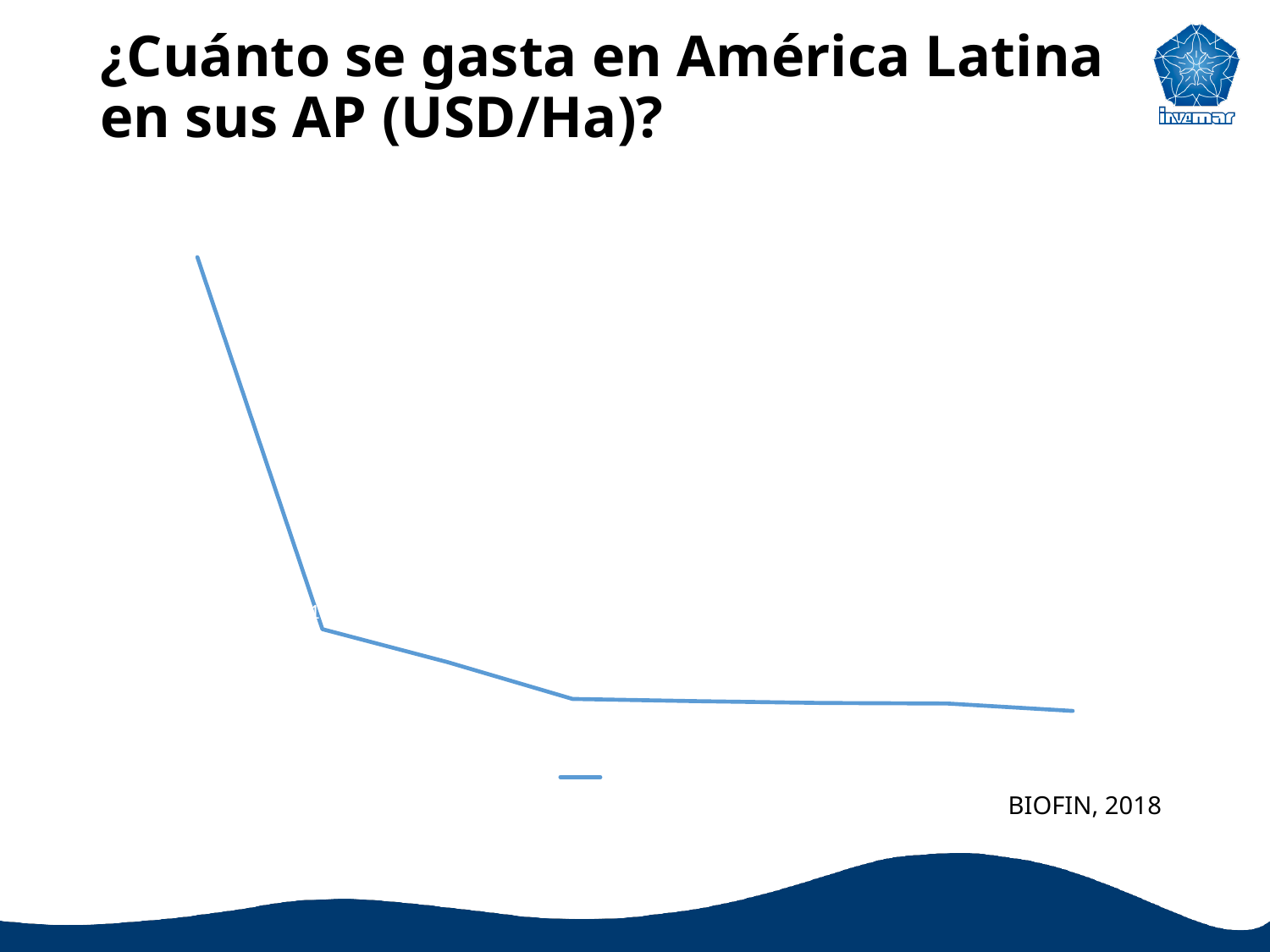
What source is cited below the chart? BIOFIN, 2018 How many series does the legend below the chart show? 1 Do the values in the line chart rise or fall from left to right along the x axis? fall What kind of chart is shown on the slide? line chart What colour is the line plotted in the chart? blue